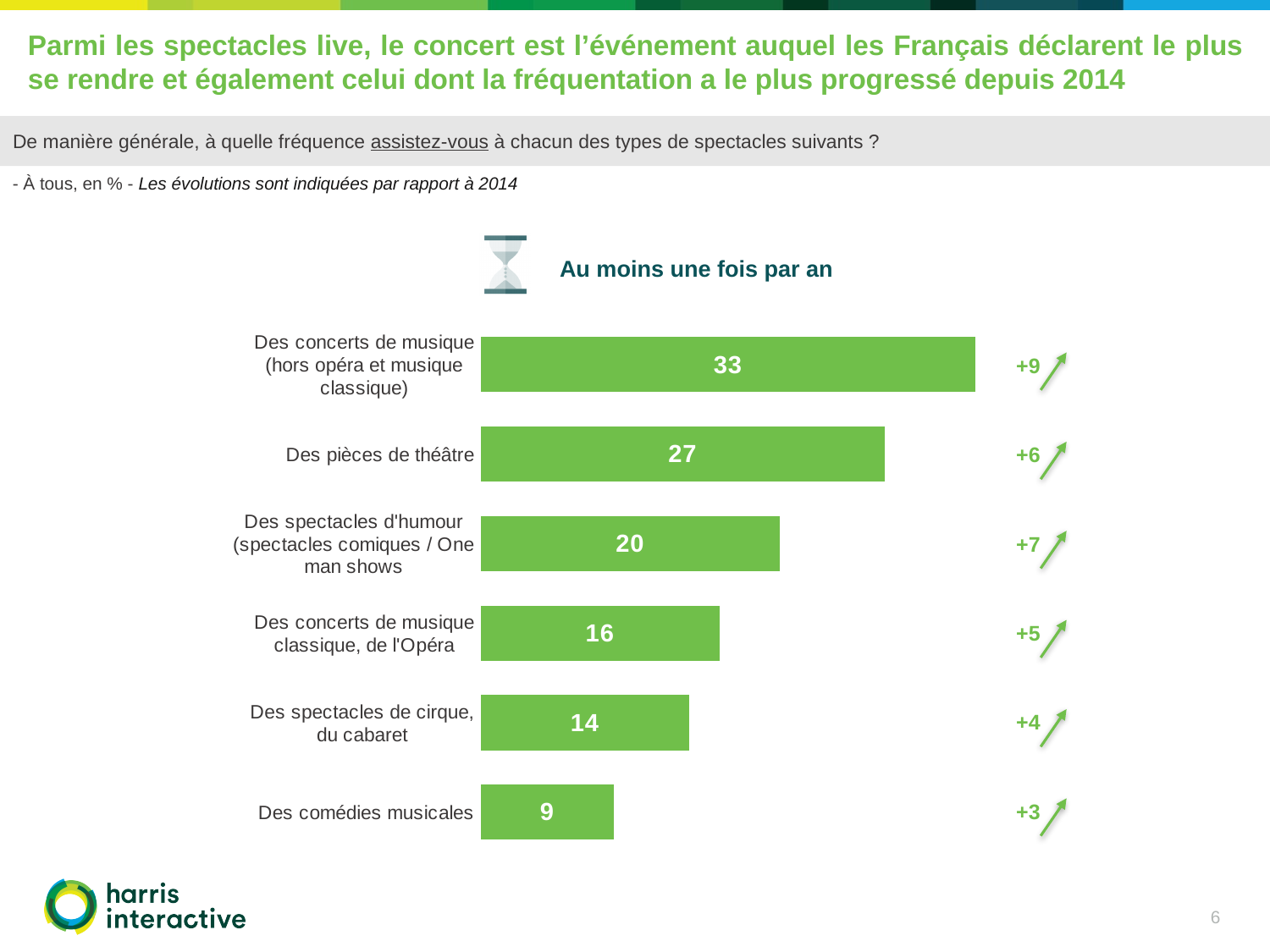
Which category has the highest value? Des concerts de musique (hors opéra et musique classique) What is the value for "Des comédies musicales"? 9 Which is larger: the value for "Des spectacles d'humour" or the value for "Des spectacles de cirque, du cabaret"? Des spectacles d'humour What is the value for "Des spectacles de cirque, du cabaret"? 14 What is the difference between the values for "Des spectacles d'humour" and "Des concerts de musique classique, de l'Opéra"? 4 What is the difference between the values for "Des concerts de musique (hors opéra et musique classique)" and "Des pièces de théâtre"? 6 What kind of chart is shown on the slide? Bar chart Which category has the lowest value? Des comédies musicales What is the value for "Des pièces de théâtre"? 27 What is the heading shown above the chart? Au moins une fois par an What change since 2014 is indicated next to the bar for "Des concerts de musique (hors opéra et musique classique)"? +9 How many categories are shown in the chart? 6